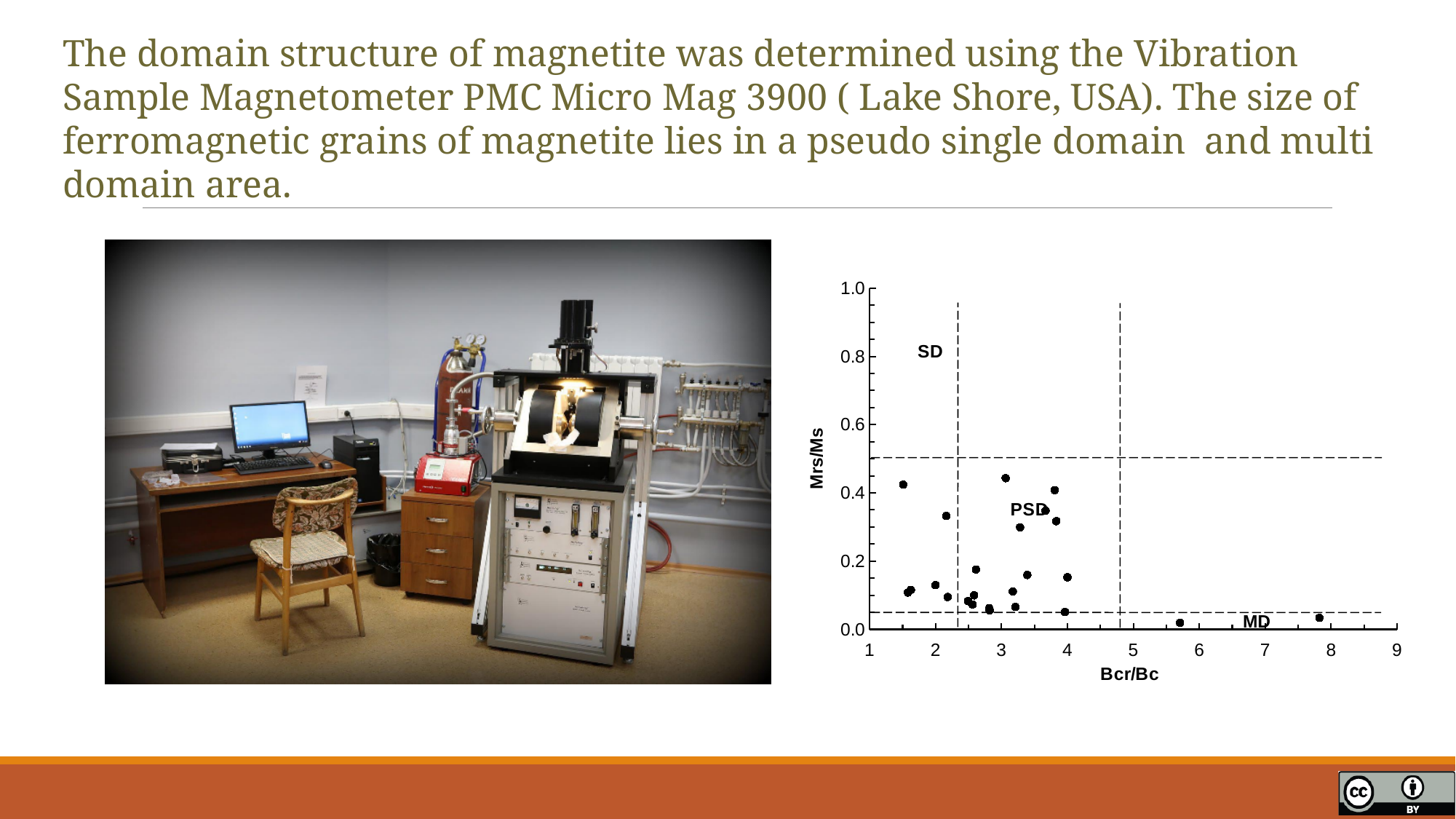
Is the Mrs/Ms value of the point with the largest Bcr/Bc (near 7.8) greater or less than 0.2? less Are any of the plotted points above the Mrs/Ms value of 0.6? No Which region of the plot contains the most points: SD, PSD or MD? PSD Is the largest Bcr/Bc value among the plotted points greater or less than 7? greater Do the points with the largest Bcr/Bc values have high or low Mrs/Ms values? low What is the label of the x axis of the scatter plot? Bcr/Bc What is the maximum value shown on the y axis of the scatter plot? 1.0 What is the label of the y axis of the scatter plot? Mrs/Ms Which region of the plot contains the points with the largest Bcr/Bc values: SD, PSD or MD? MD What kind of chart is shown on the right side of the slide? scatter plot